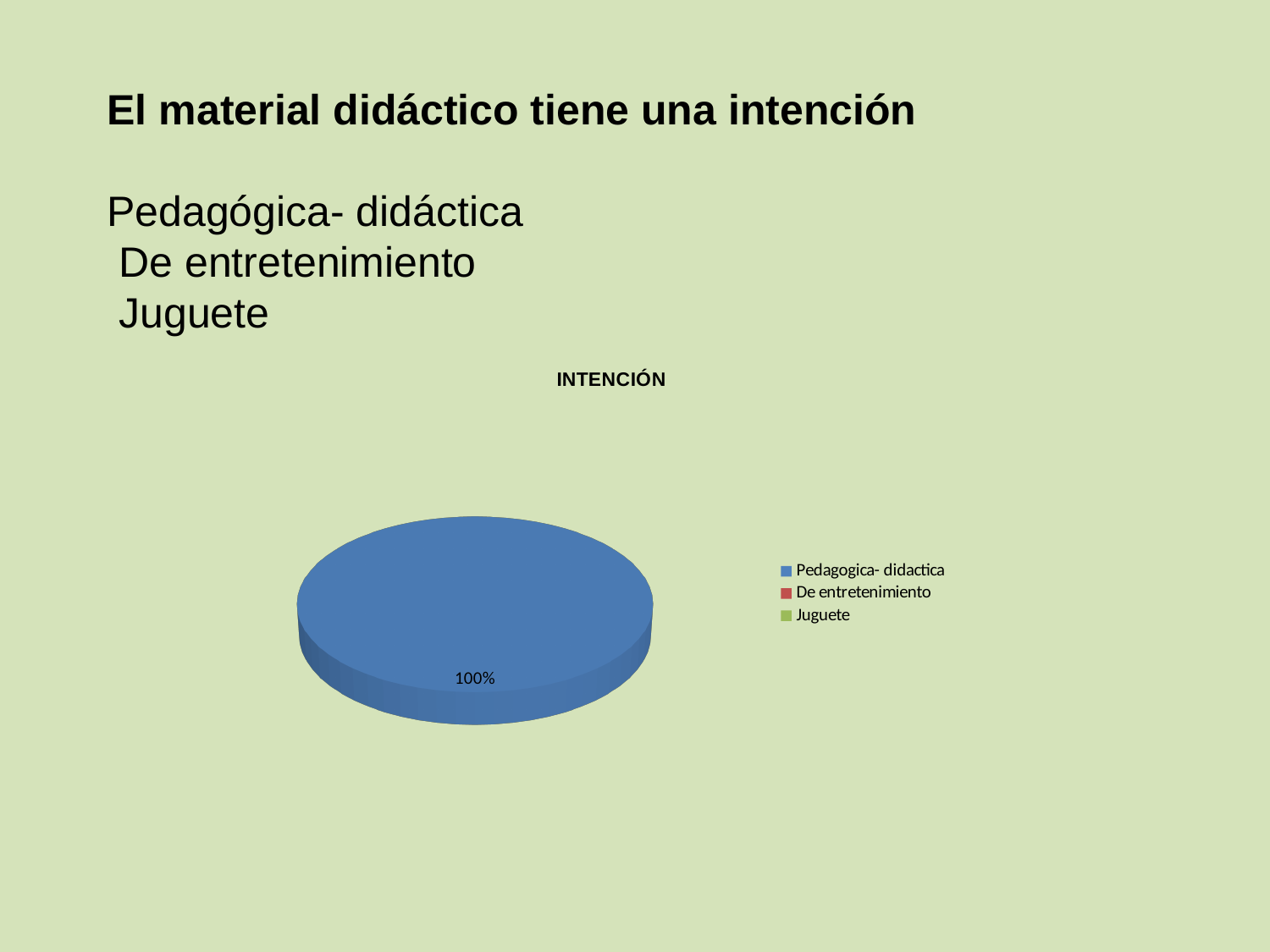
Which is larger, the share for Pedagogica- didactica or the share for De entretenimiento? Pedagogica- didactica What is the only percentage label printed on the pie? 100% What share of the pie does Pedagogica- didactica take? 100% Is the share for Pedagogica- didactica greater or less than 50%? greater How many entries does the chart's legend list? 3 Which legend entry is shown in blue? Pedagogica- didactica Which is larger, the share for Pedagogica- didactica or the share for Juguete? Pedagogica- didactica What is the title of the chart? INTENCIÓN What kind of chart is shown on the slide? pie chart Which category has the largest share of the pie? Pedagogica- didactica